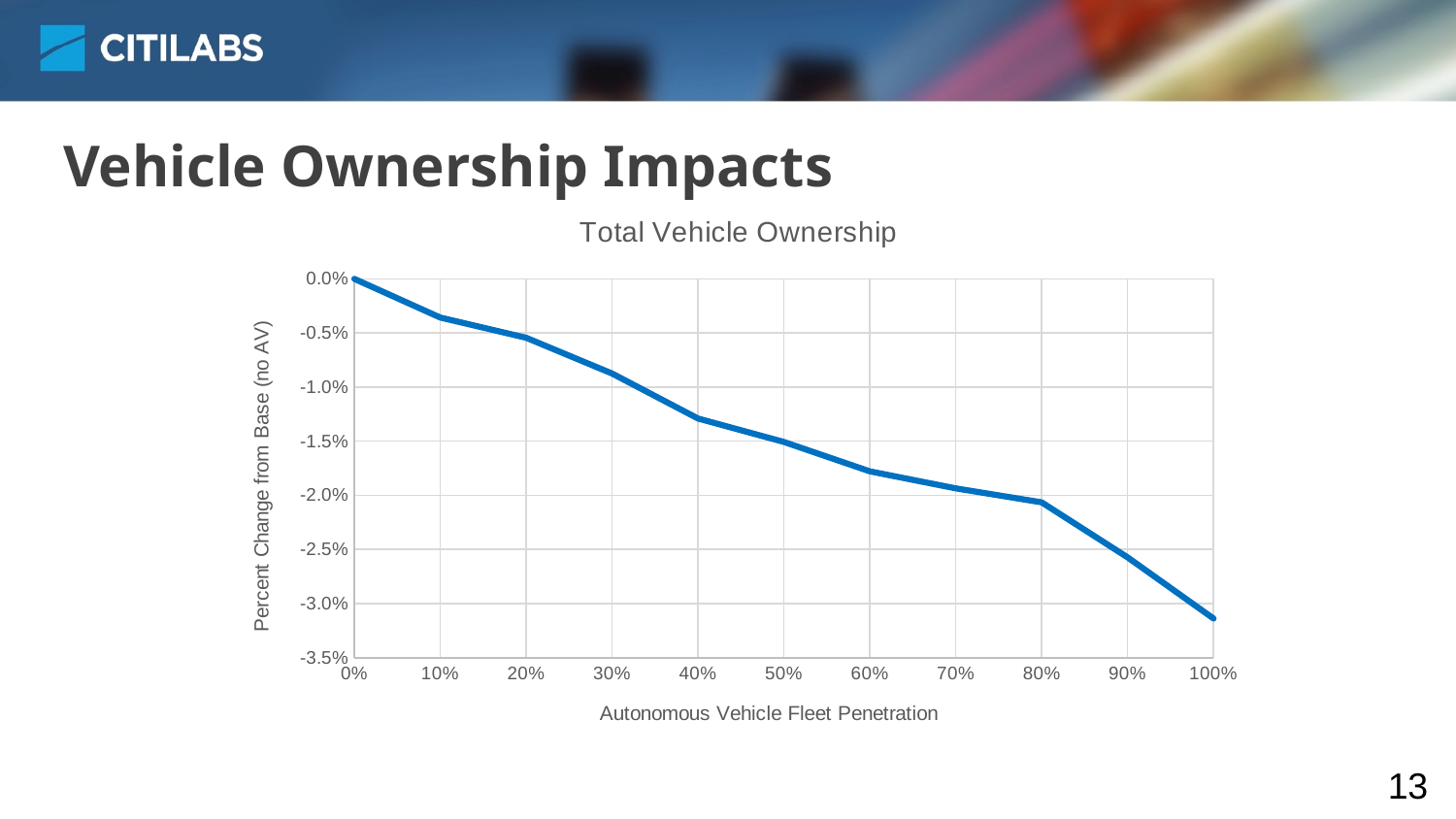
What is the percent change from base at 0% autonomous vehicle fleet penetration? 0.0% What is the title of the chart? Total Vehicle Ownership At which fleet penetration level is the percent change from base highest? 0% Is the value at 20% fleet penetration greater or less than -1.0%? greater Which is larger, the value at 30% fleet penetration or the value at 90% fleet penetration? 30% What kind of chart is shown on the slide? line chart Is the value at 100% fleet penetration greater or less than -3.0%? less Do the values rise or fall as autonomous vehicle fleet penetration increases? fall What is the label of the x axis? Autonomous Vehicle Fleet Penetration Is the value at 40% fleet penetration greater or less than -1.0%? less How many data points are plotted on the line? 11 At which fleet penetration level is the percent change from base lowest? 100%